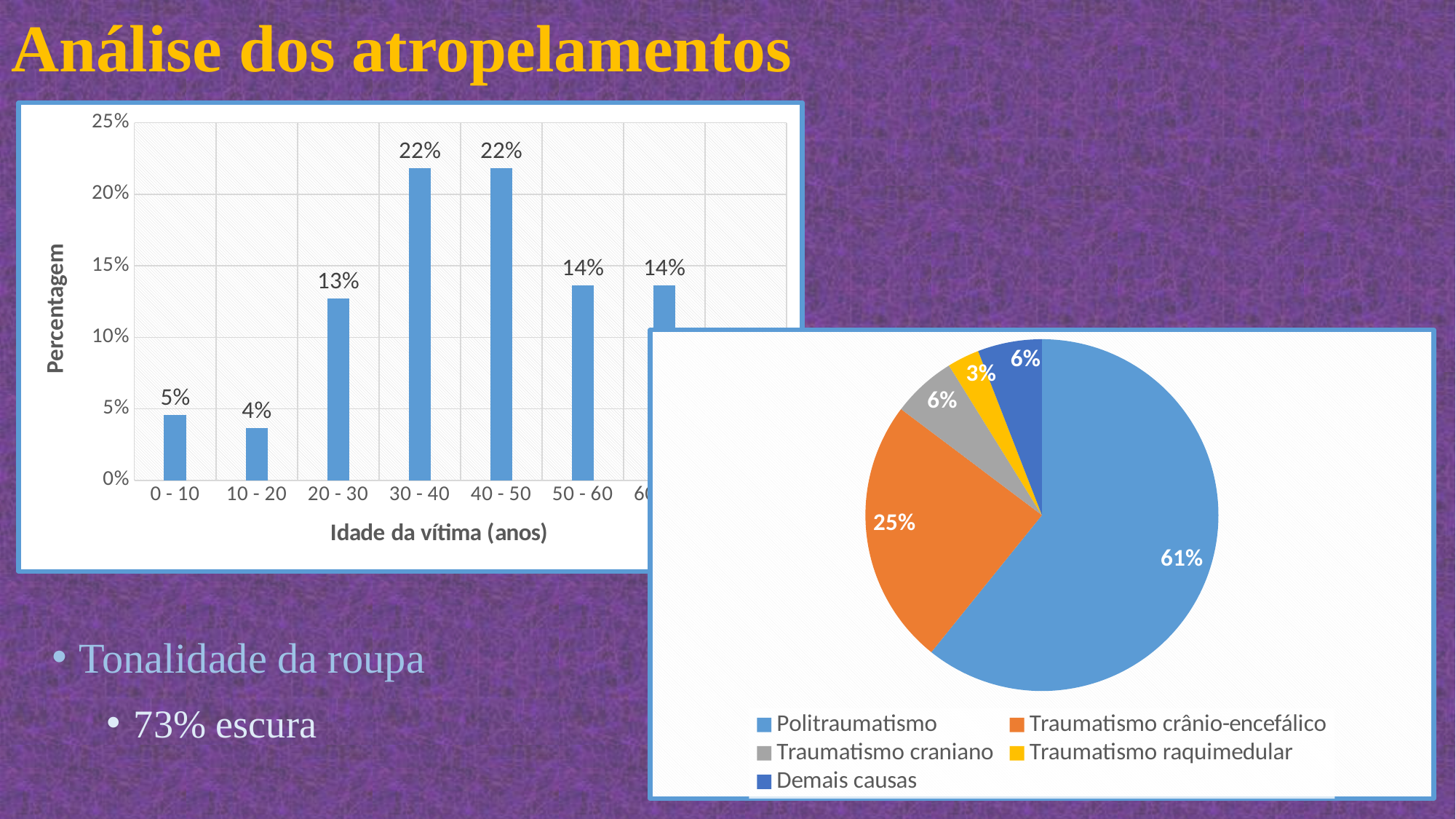
In the bar chart on the left, what is the percentage for victims aged 10 - 20? 4% In the pie chart on the right, which category has the largest slice? Politraumatismo In the bar chart on the left, which has a higher percentage: the 20 - 30 age group or the 50 - 60 age group? 50 - 60 In the pie chart on the right, what share does Traumatismo raquimedular have? 3% How many entries does the legend of the pie chart on the right list? 5 In the bar chart on the left, is the value for the 40 - 50 age group greater or less than 20%? greater In the bar chart on the left, what is the difference between the percentages for the 30 - 40 and 0 - 10 age groups? 17% What type of chart is the chart on the left? bar chart In the bar chart on the left, what is the percentage for victims aged 20 - 30? 13% In the pie chart on the right, what share does Politraumatismo have? 61% In the bar chart on the left, which age group has the lowest percentage? 10 - 20 In the bar chart on the left, what is the label of the x axis? Idade da vítima (anos)